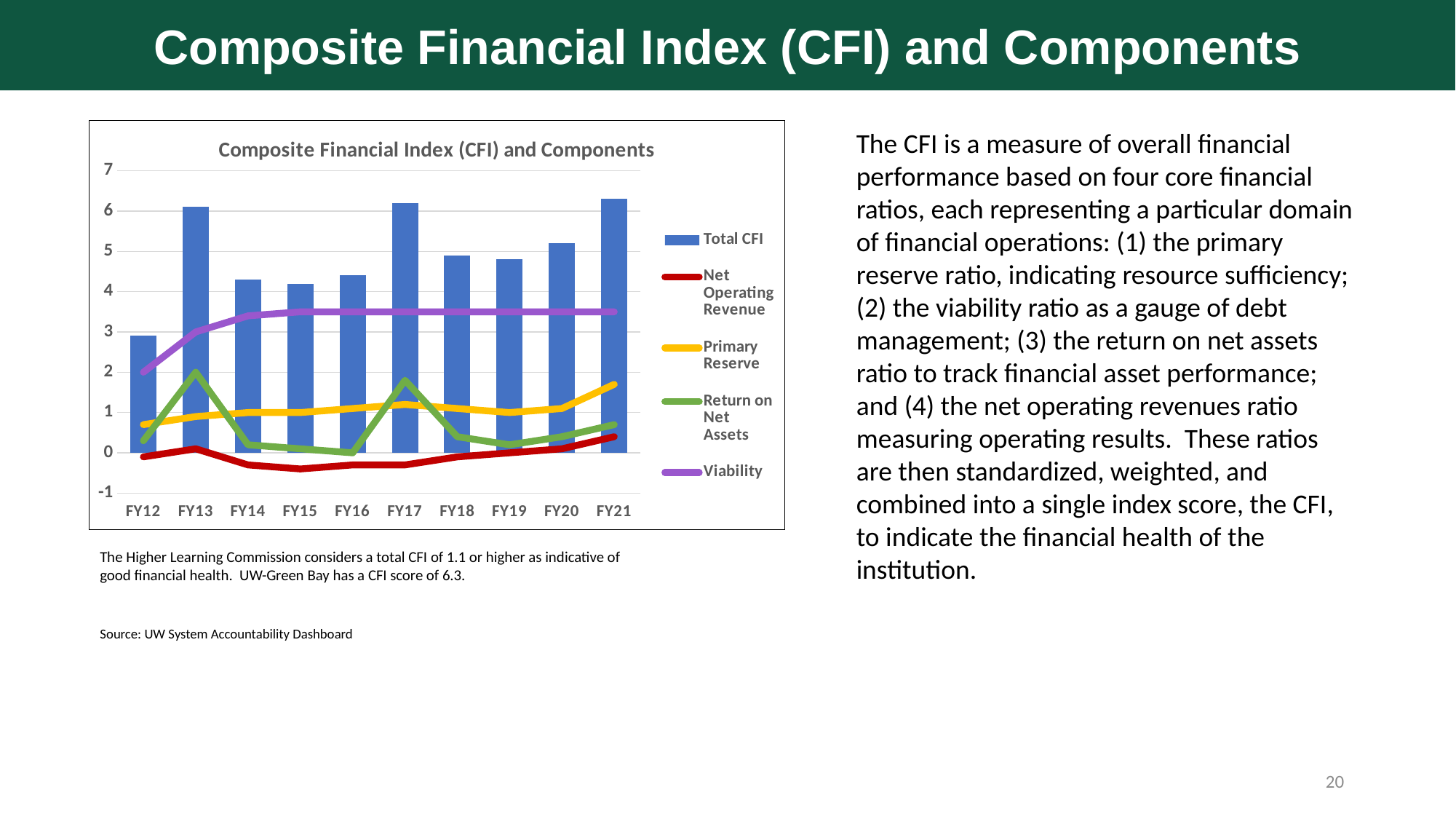
Is the Viability value for FY21 greater or less than 3? greater How many fiscal years are shown on the x axis of the chart? 10 Which has the larger Total CFI, FY12 or FY20? FY20 Which fiscal year has the lowest Total CFI bar? FY12 Which has the larger Total CFI, FY13 or FY14? FY13 What kind of chart is shown on the slide? A combined bar and line chart Is the Net Operating Revenue value for FY15 greater or less than 0? less Which series is drawn in purple in the chart? Viability How many series does the chart legend list? 5 Is the Total CFI value for FY13 greater or less than 5? greater